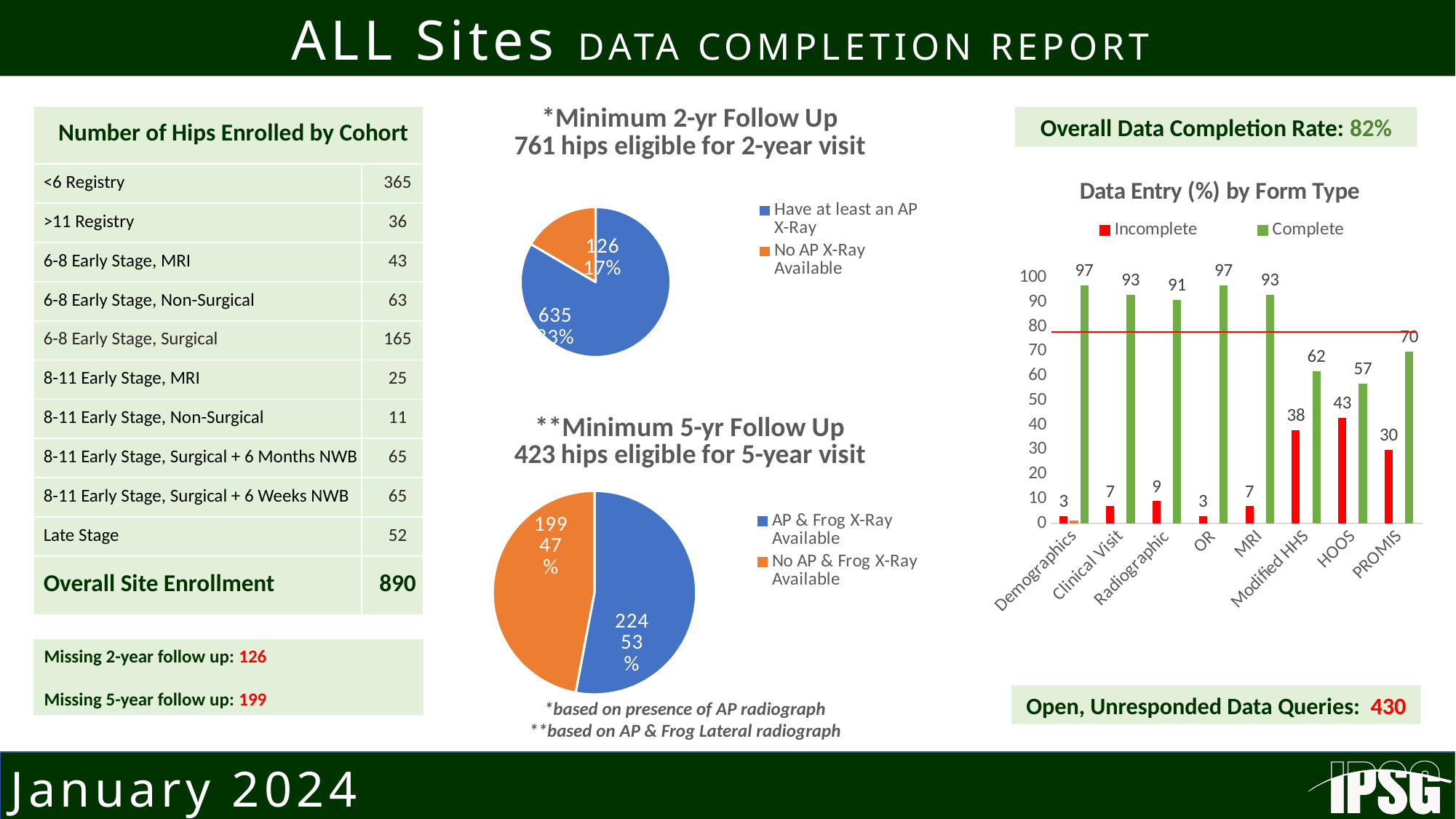
In the 'Data Entry (%) by Form Type' bar chart, how many form types are shown on the x axis? 8 In the 'Data Entry (%) by Form Type' bar chart, what is the Complete value for Radiographic? 91 In the 'Data Entry (%) by Form Type' bar chart, what is the Incomplete value for HOOS? 43 In the 'Minimum 2-yr Follow Up' pie chart, how many hips have no AP X-Ray available? 126 In the 'Minimum 5-yr Follow Up' pie chart, what share of hips have AP & Frog X-Ray available? 53% In the 'Data Entry (%) by Form Type' bar chart, which form type has the highest Incomplete value? HOOS In the 'Minimum 5-yr Follow Up' pie chart, which slice is larger: 'AP & Frog X-Ray Available' or 'No AP & Frog X-Ray Available'? AP & Frog X-Ray Available In the 'Data Entry (%) by Form Type' bar chart, how many series does the legend list? 2 In the 'Minimum 2-yr Follow Up' pie chart, what share of hips have no AP X-Ray available? 17% In the 'Data Entry (%) by Form Type' bar chart, what is the difference between the Complete values for Demographics and PROMIS? 27 What kind of chart is 'Data Entry (%) by Form Type'? Bar chart In the 'Data Entry (%) by Form Type' bar chart, which form type has the lowest Complete value? HOOS